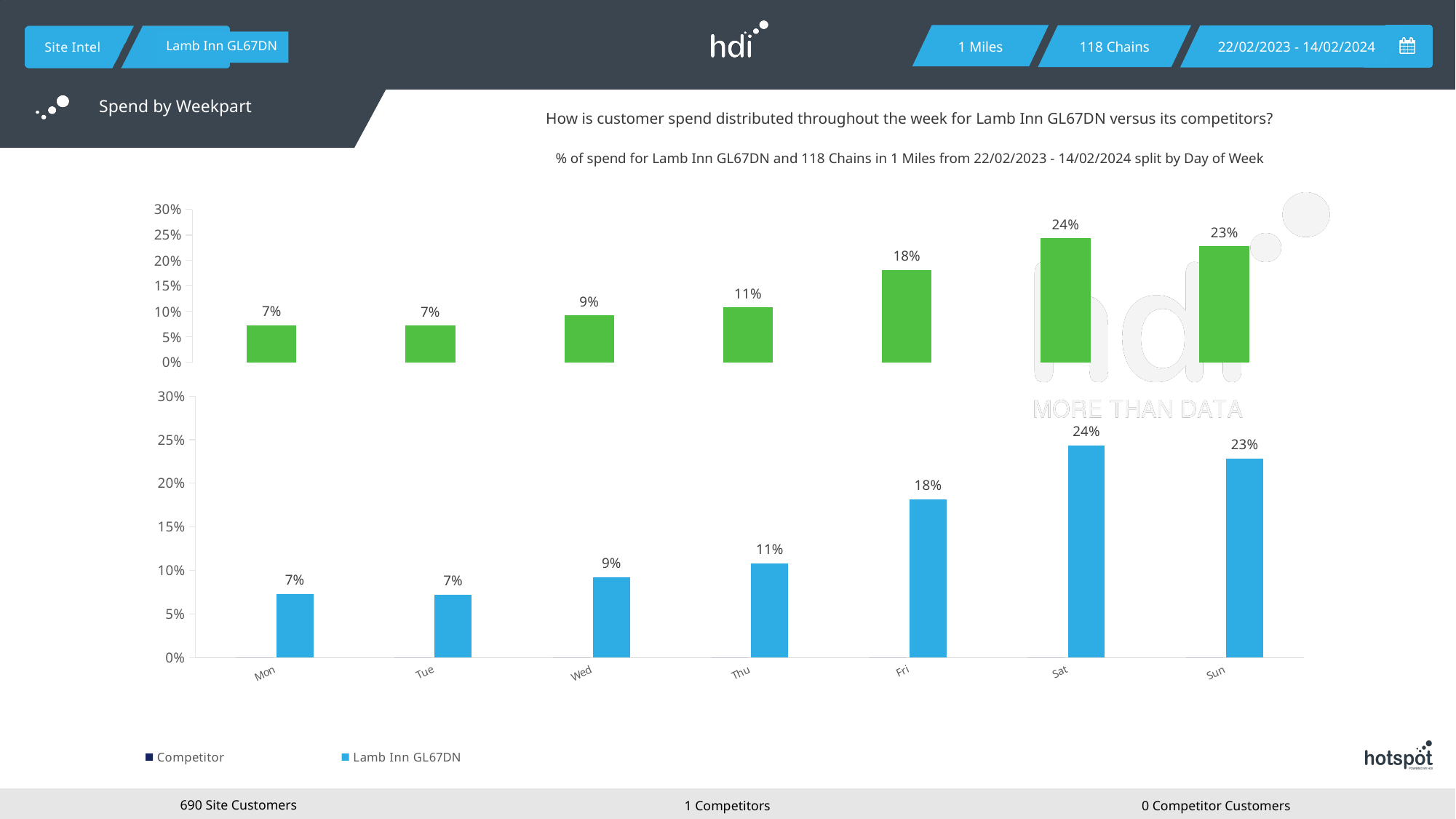
In the bottom chart, which day has the highest value? Sat How many series does the legend at the bottom of the slide list? 2 In the bottom chart, what is the value for Sat? 24% What kind of chart is the bottom chart? bar chart How many days are shown on the x axis of the bottom chart? 7 In the top chart, what is the value of the highest bar? 24% In the bottom chart, which is larger, the value for Fri or the value for Wed? Fri In the bottom chart, is the value for Sun greater or less than 20%? greater In the bottom chart, what is the difference between the values for Sat and Mon? 17% In the bottom chart, do the values generally rise or fall from Mon to Sat? rise In the bottom chart, what is the value for Thu? 11% What is the title shown in the top-left panel of the slide? Spend by Weekpart